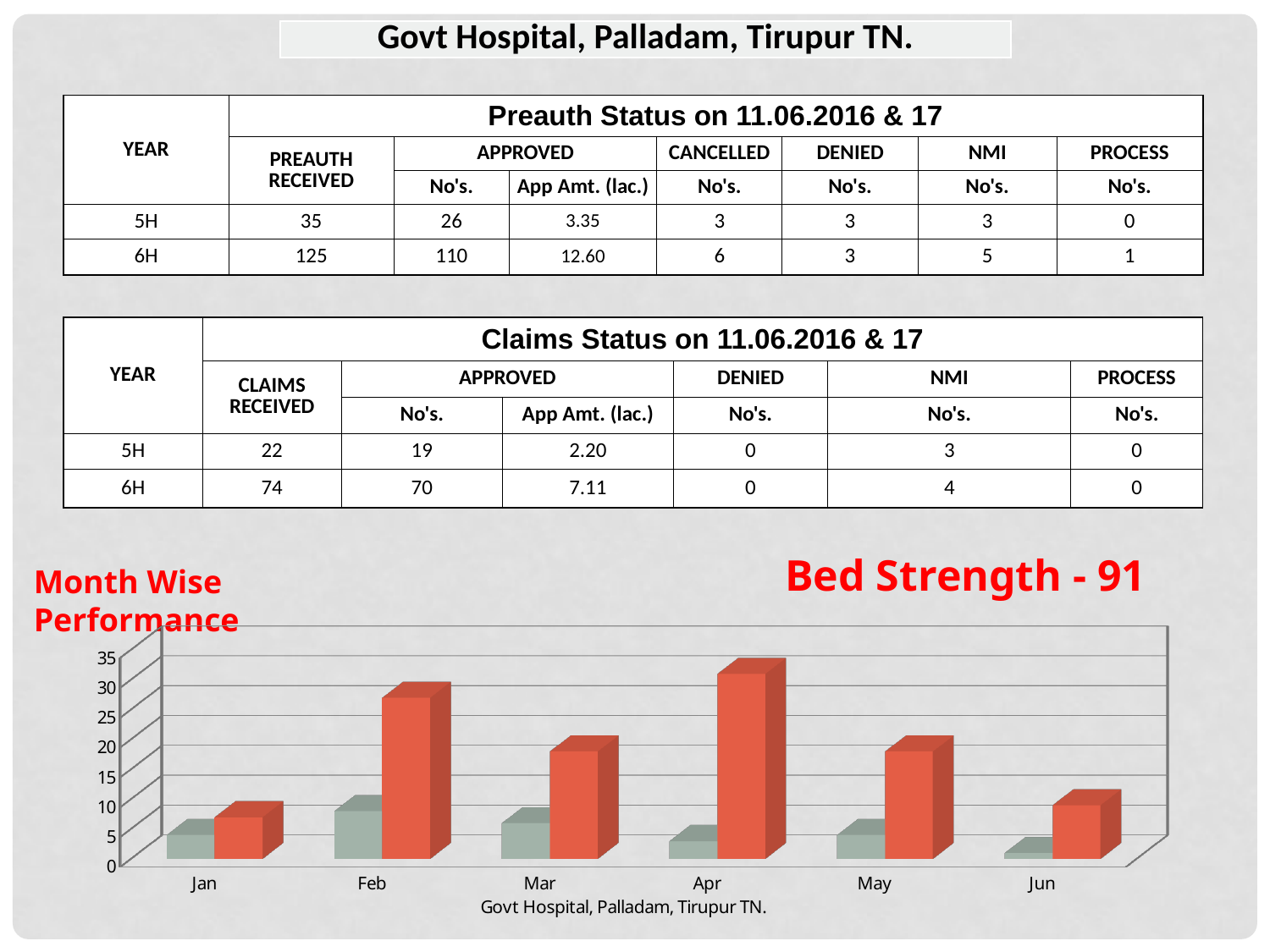
How many bars are plotted for each month in the Month Wise Performance chart? 2 What text appears below the x axis of the Month Wise Performance chart? Govt Hospital, Palladam, Tirupur TN. In which month is the grey bar the tallest in the Month Wise Performance chart? Feb How many months are shown on the x axis of the Month Wise Performance chart? 6 In which month is the red bar the tallest in the Month Wise Performance chart? Apr Is the red bar for Jan greater or less than 10? less Does the red bar rise or fall from Apr to Jun in the Month Wise Performance chart? fall In which month is the red bar the shortest in the Month Wise Performance chart? Jan Which is larger in the Month Wise Performance chart, the red bar for Feb or the red bar for Mar? Feb Is the red bar for Feb greater or less than 20? greater Is the red bar for Apr greater or less than 25? greater What kind of chart is shown under 'Month Wise Performance'? bar chart